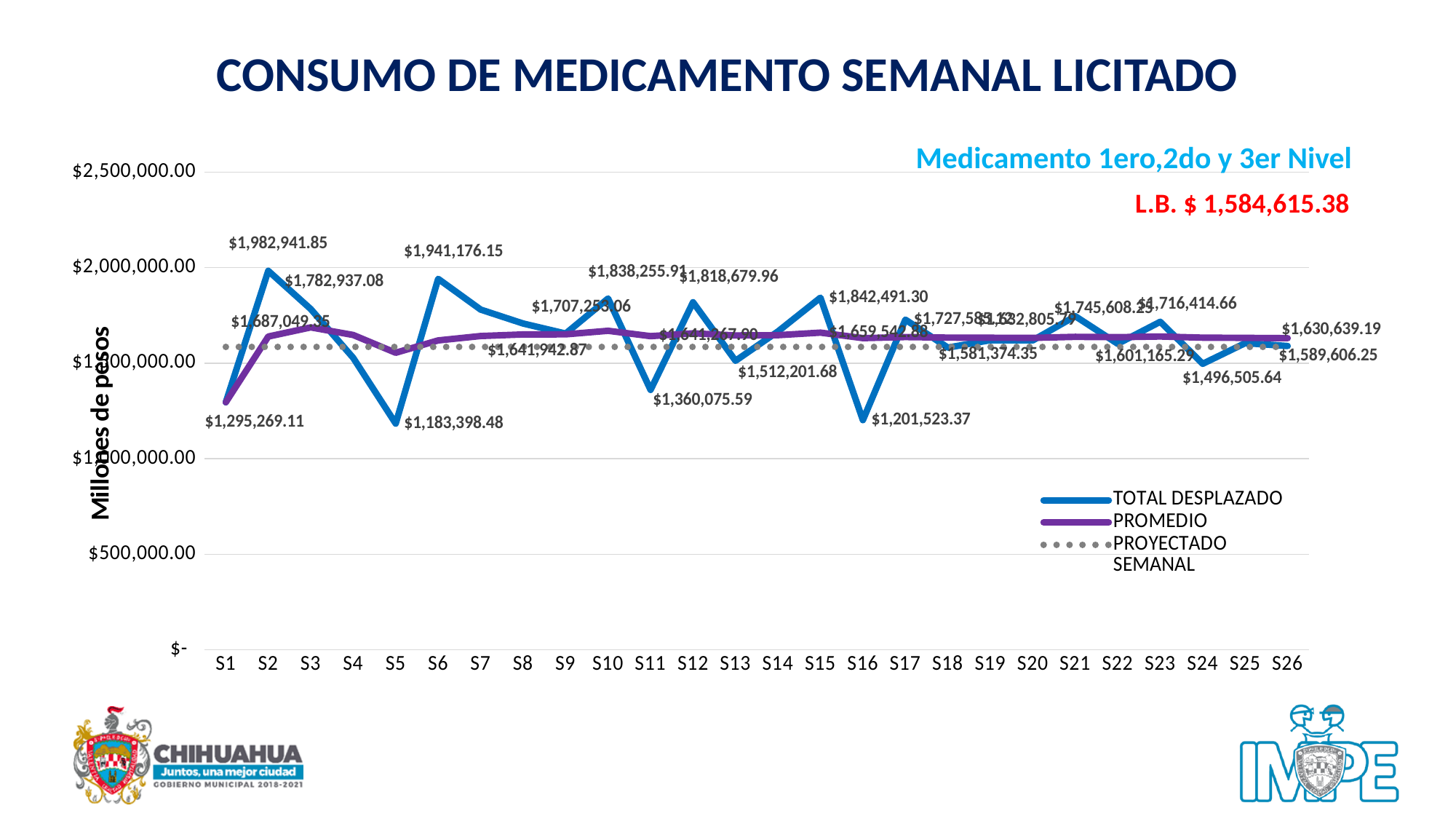
What is the TOTAL DESPLAZADO value for S5? $1,183,398.48 What kind of chart is shown on the slide? line chart What is the TOTAL DESPLAZADO value for S2? $1,982,941.85 What L.B. value is shown in red on the slide? $ 1,584,615.38 What is the difference between the TOTAL DESPLAZADO values for S2 and S5? $799,543.37 Is the TOTAL DESPLAZADO value for S16 greater or less than $1,500,000.00? less What is the TOTAL DESPLAZADO value for S16? $1,201,523.37 In which week is TOTAL DESPLAZADO highest? S2 What is the TOTAL DESPLAZADO value for S1? $1,295,269.11 How many weeks (S1 to S26) are plotted on the x axis? 26 How many series does the legend list? 3 In which week is TOTAL DESPLAZADO lowest? S5